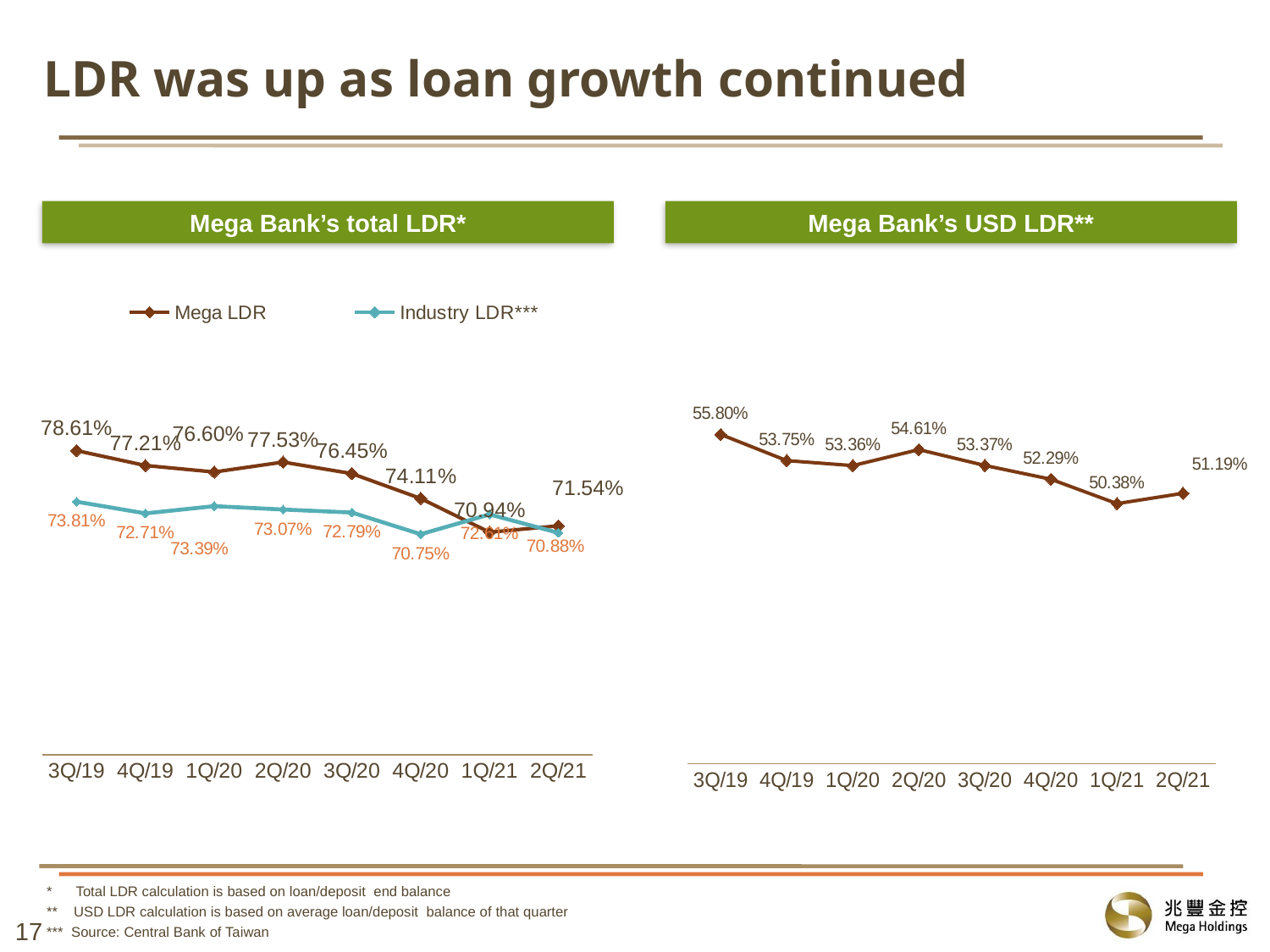
In the 'Mega Bank's total LDR*' chart, which quarter has the lowest Mega LDR value? 1Q/21 In the 'Mega Bank's total LDR*' chart, what is the Mega LDR value for 3Q/19? 78.61% In the 'Mega Bank's USD LDR**' chart, which quarter has the lowest value? 1Q/21 In the 'Mega Bank's total LDR*' chart, what is the Industry LDR*** value for 1Q/20? 73.39% In the 'Mega Bank's USD LDR**' chart, what is the value for 2Q/21? 51.19% How many quarters are shown on the x axis of the 'Mega Bank's USD LDR**' chart? 8 What kind of chart is the 'Mega Bank's total LDR*' chart? line chart In the 'Mega Bank's total LDR*' chart, what is the difference between the Mega LDR values for 3Q/19 and 2Q/21? 7.07 percentage points In the 'Mega Bank's USD LDR**' chart, which quarter has the highest value? 3Q/19 How many series does the legend of the 'Mega Bank's total LDR*' chart list? 2 In the 'Mega Bank's total LDR*' chart, which is larger at 4Q/20: Mega LDR or Industry LDR***? Mega LDR In the 'Mega Bank's USD LDR**' chart, what is the difference between the values for 3Q/19 and 4Q/19? 2.05 percentage points